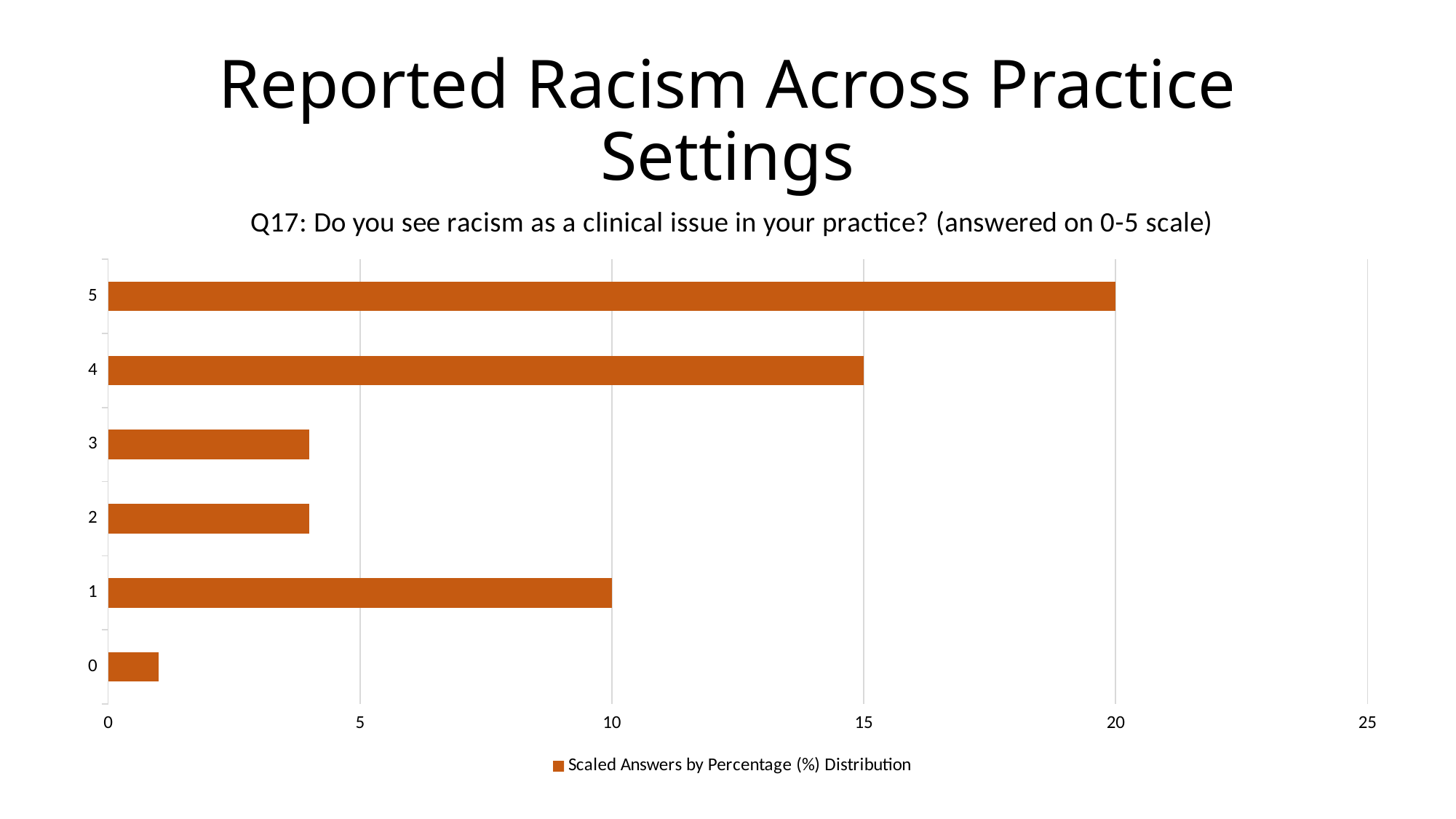
Which scale answer has the highest value? 5 What type of chart is shown on the slide? Bar chart Is the value for scale answer 3 greater or less than 5? less Which scale answer has the lowest value? 0 What is the legend entry for the series? Scaled Answers by Percentage (%) Distribution Which has a larger value, scale answer 4 or scale answer 1? 4 What is the value for scale answer 1? 10 How many series does the legend list? 1 What is the value for scale answer 4? 15 What is the difference between the values for scale answers 5 and 4? 5 How many categories are shown on the chart? 6 What is the value for scale answer 5? 20